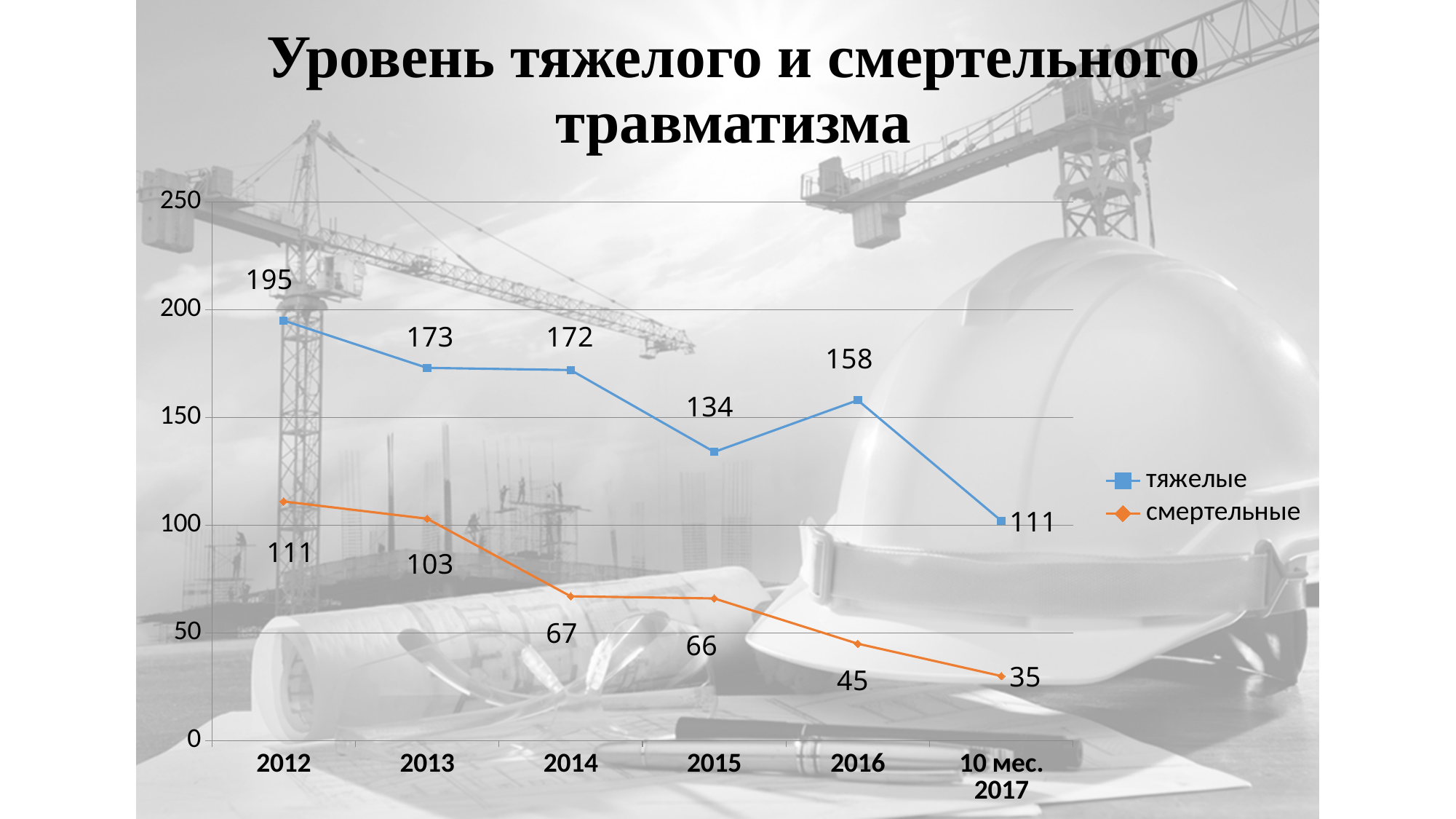
In which year is the value for тяжелые highest? 2012 What is the value for смертельные in 2014? 67 What is the difference between the тяжелые values in 2012 and 10 мес. 2017? 84 What is the value for смертельные for 10 мес. 2017? 35 How many series does the legend list? 2 Do the values for смертельные rise or fall from 2012 to 10 мес. 2017? fall Which is larger: the смертельные value in 2013 or in 2016? 2013 What is the value for тяжелые in 2016? 158 In which period is the value for смертельные lowest? 10 мес. 2017 What kind of chart is shown on the slide? line chart How many periods are shown on the x axis? 6 What is the value for тяжелые in 2012? 195